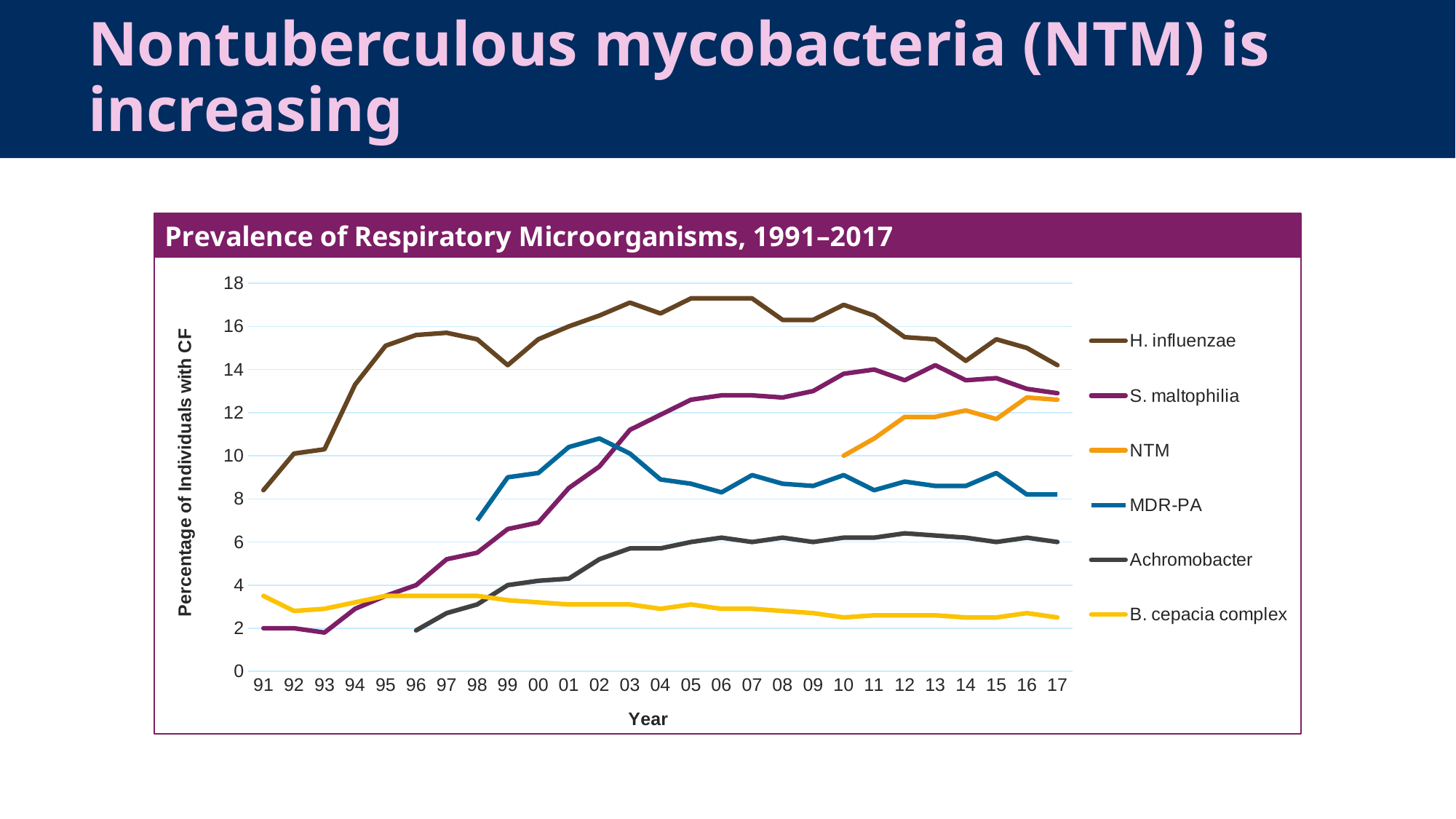
In 02, which is larger: MDR-PA or S. maltophilia? MDR-PA How many series does the legend list? 6 Is the value for Achromobacter in 12 greater or less than 8? less Which series has the lowest value in 17? B. cepacia complex Is the value for B. cepacia complex in 17 greater or less than 4? less What kind of chart is shown on the slide? Line chart Does the NTM series rise or fall from 10 to 17? Rises What is the title of the chart? Prevalence of Respiratory Microorganisms, 1991–2017 Is the value for NTM in 16 greater or less than 12? greater How many years are shown along the x axis? 27 Which series has the highest value in 17? H. influenzae